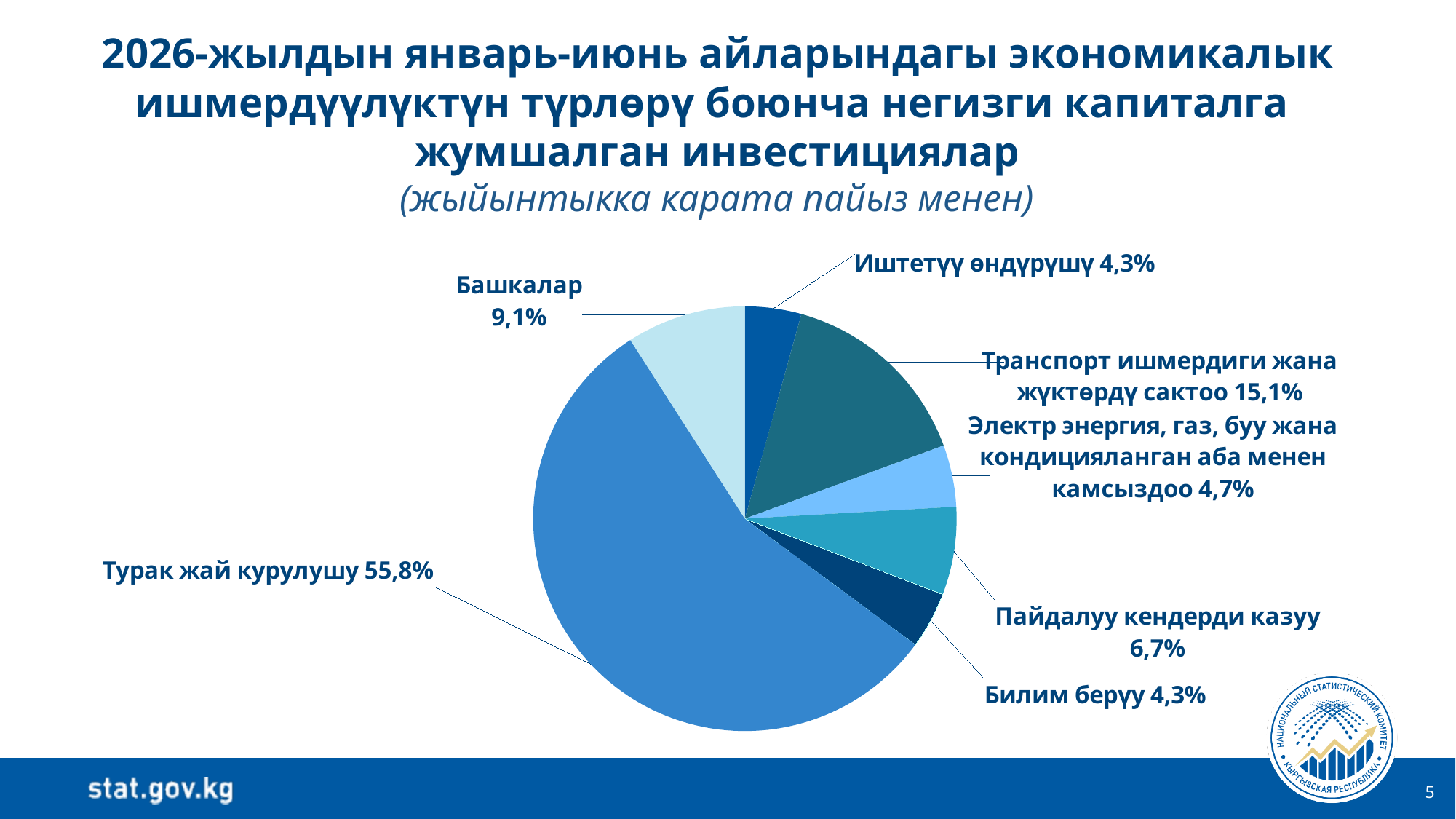
Which category has the largest share of the pie? Турак жай курулушу What is the share for Башкалар? 9,1% What kind of chart is shown on the slide? pie chart What is the subtitle shown in italics under the chart title? (жыйынтыкка карата пайыз менен) Which is larger: the share for Пайдалуу кендерди казуу or the share for Билим берүү? Пайдалуу кендерди казуу What is the share for Электр энергия, газ, буу жана кондицияланган аба менен камсыздоо? 4,7% What is the share for Пайдалуу кендерди казуу? 6,7% What is the share for Турак жай курулушу? 55,8% What is the difference in percentage points between Турак жай курулушу and Транспорт ишмердиги жана жүктөрдү сактоо? 40,7 What is the difference in percentage points between Транспорт ишмердиги жана жүктөрдү сактоо and Башкалар? 6,0 How many slices does the pie chart have? 7 What is the share for Транспорт ишмердиги жана жүктөрдү сактоо? 15,1%